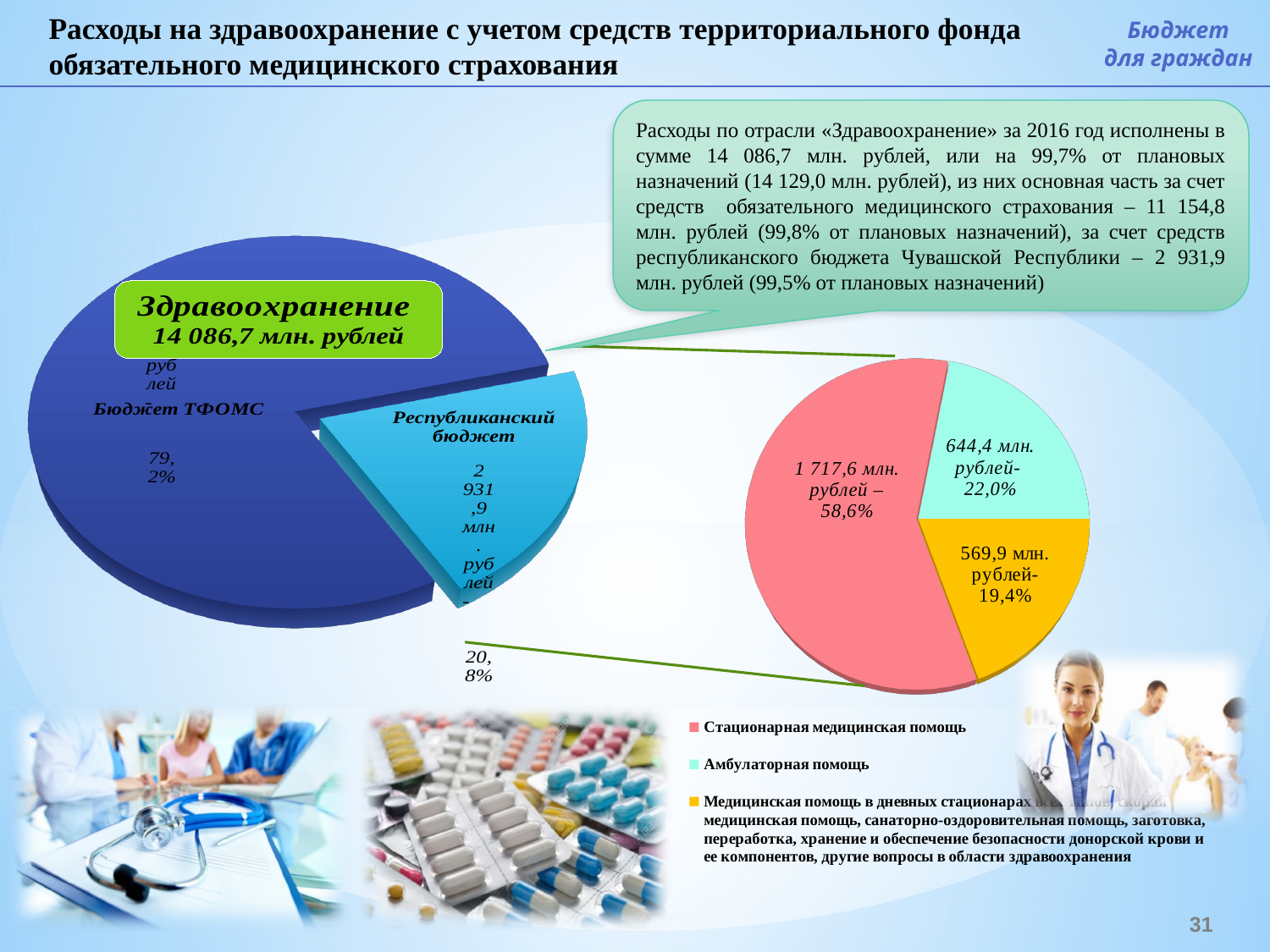
In the left pie chart, what percentage is shown for Бюджет ТФОМС? 79,2% In the right pie chart, what share is shown for the slice with 644,4 млн. рублей? 22,0% In the right pie chart, what amount in млн. рублей corresponds to the 19,4% slice? 569,9 млн. рублей In the right pie chart, what value is shown for the slice labelled 1 717,6 млн. рублей? 58,6% How many slices does the right pie chart have? 3 In the right pie chart, what is the difference in млн. рублей between the 644,4 slice and the 569,9 slice? 74,5 млн. рублей In the left pie chart, which slice is larger: Бюджет ТФОМС or Республиканский бюджет? Бюджет ТФОМС In the right pie chart, which slice is the largest? 1 717,6 млн. рублей – 58,6% (Стационарная медицинская помощь) What kind of chart is the chart on the right side of the slide? pie chart How many entries does the legend below the right pie chart list? 3 In the right pie chart, which slice is the smallest? 569,9 млн. рублей - 19,4%